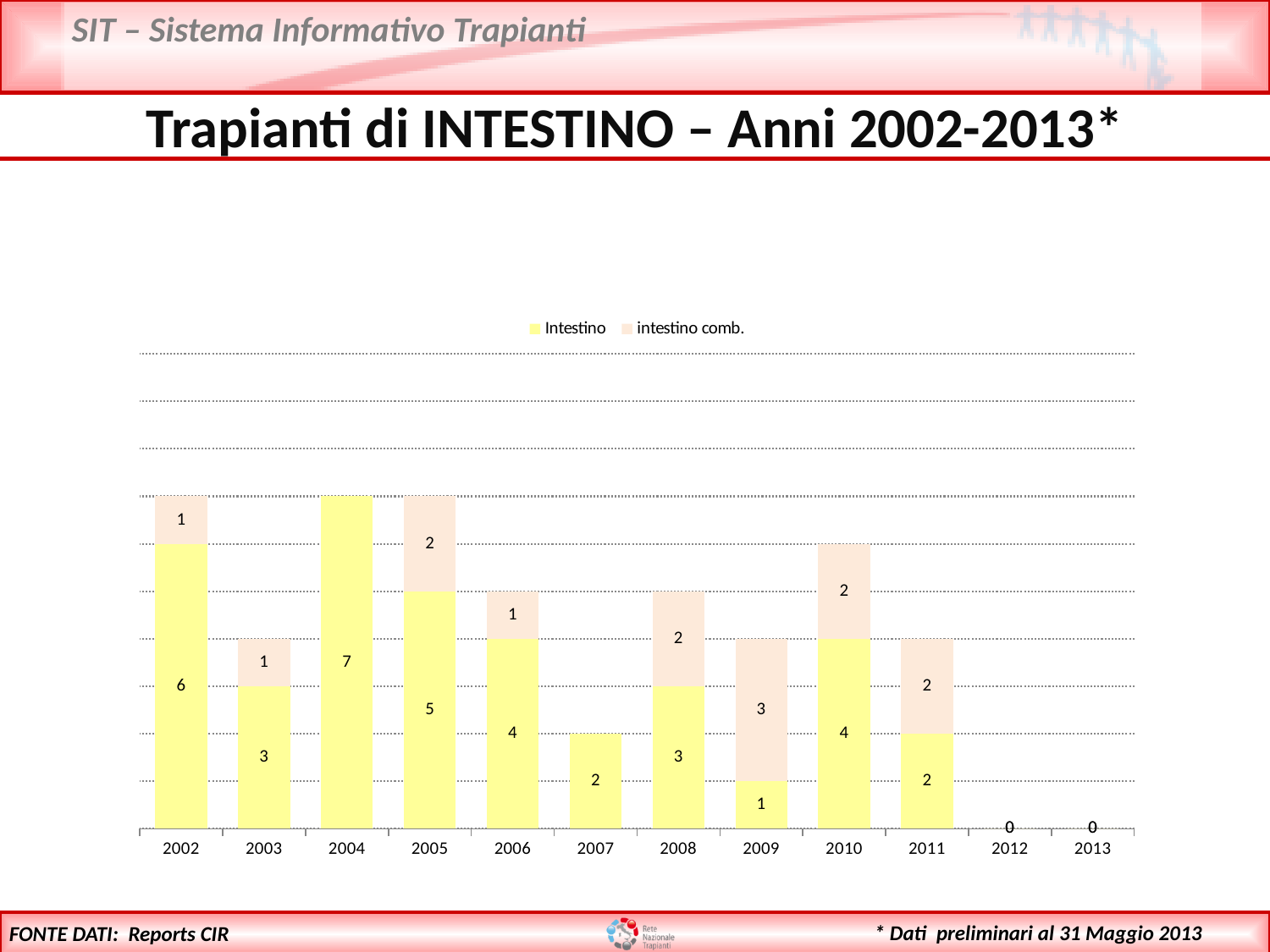
What kind of chart is shown on the slide? Stacked bar chart What is the value for Intestino in 2002? 6 What is the value for intestino comb. in 2009? 3 Which year has the highest value for Intestino? 2004 Which is larger, the Intestino value for 2005 or for 2008? 2005 What is the value for Intestino in 2004? 7 What is the total of the stacked bar for 2005? 7 Which year has the highest value for intestino comb.? 2009 How many years are shown on the x axis? 12 What is the total of the stacked bar for 2010? 6 How many series does the legend list? 2 What is the difference between the Intestino values for 2002 and 2003? 3